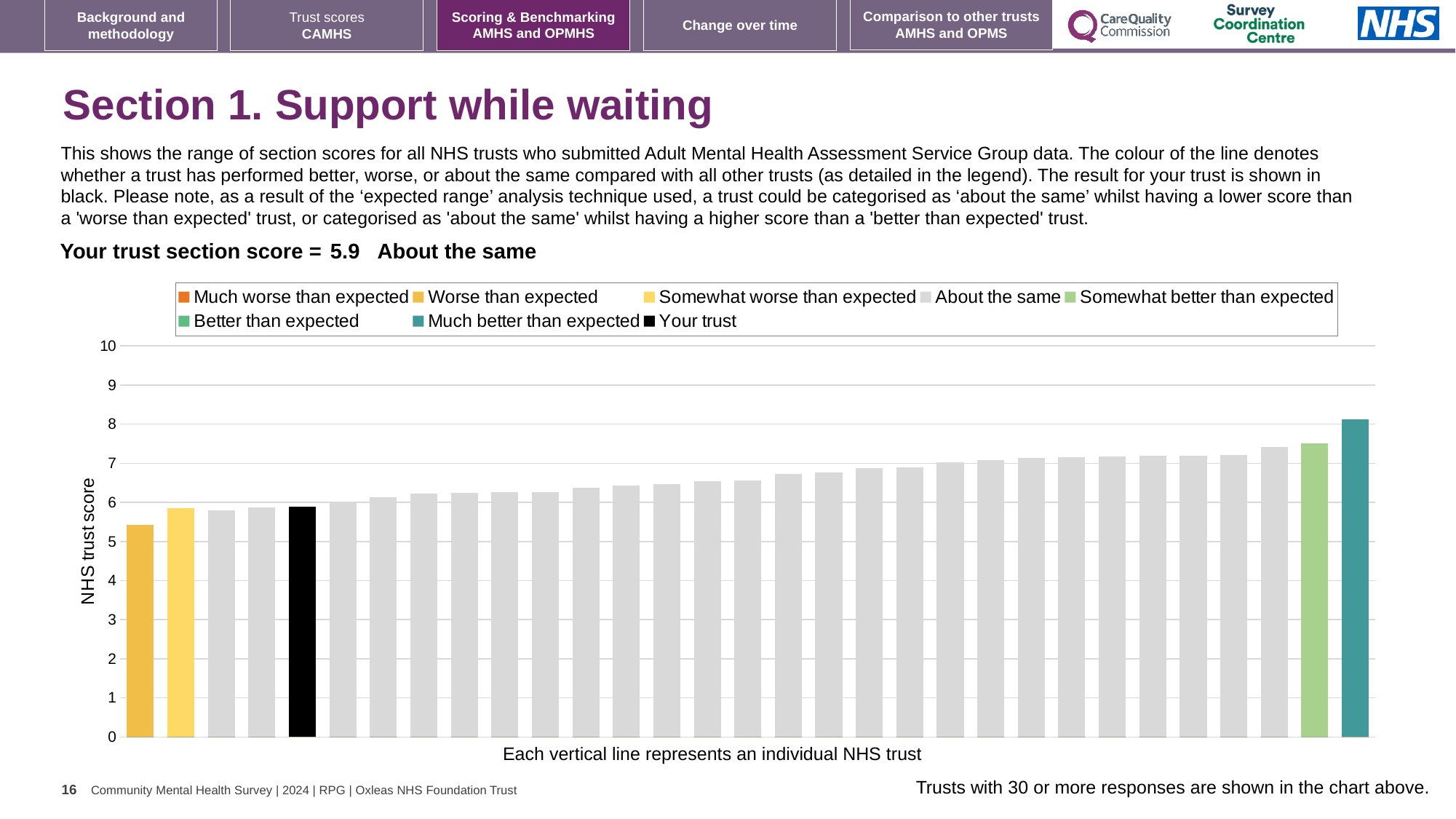
Do the bar values rise or fall from left to right along the x axis? rise What is the label on the y axis of the chart? NHS trust score Is the value for the leftmost bar greater or less than 6? less Is the value for the black 'Your trust' bar greater or less than 5? greater Which is larger, the rightmost teal bar or the black 'Your trust' bar? the rightmost teal bar Is the value for the light green 'Somewhat better than expected' bar greater or less than 7? greater Which legend category does the tallest bar belong to? Much better than expected What is your trust's section score shown on the slide? 5.9 What kind of chart is shown on the slide? bar chart What category is your trust's score placed in according to the slide? About the same How many entries does the chart legend list? 8